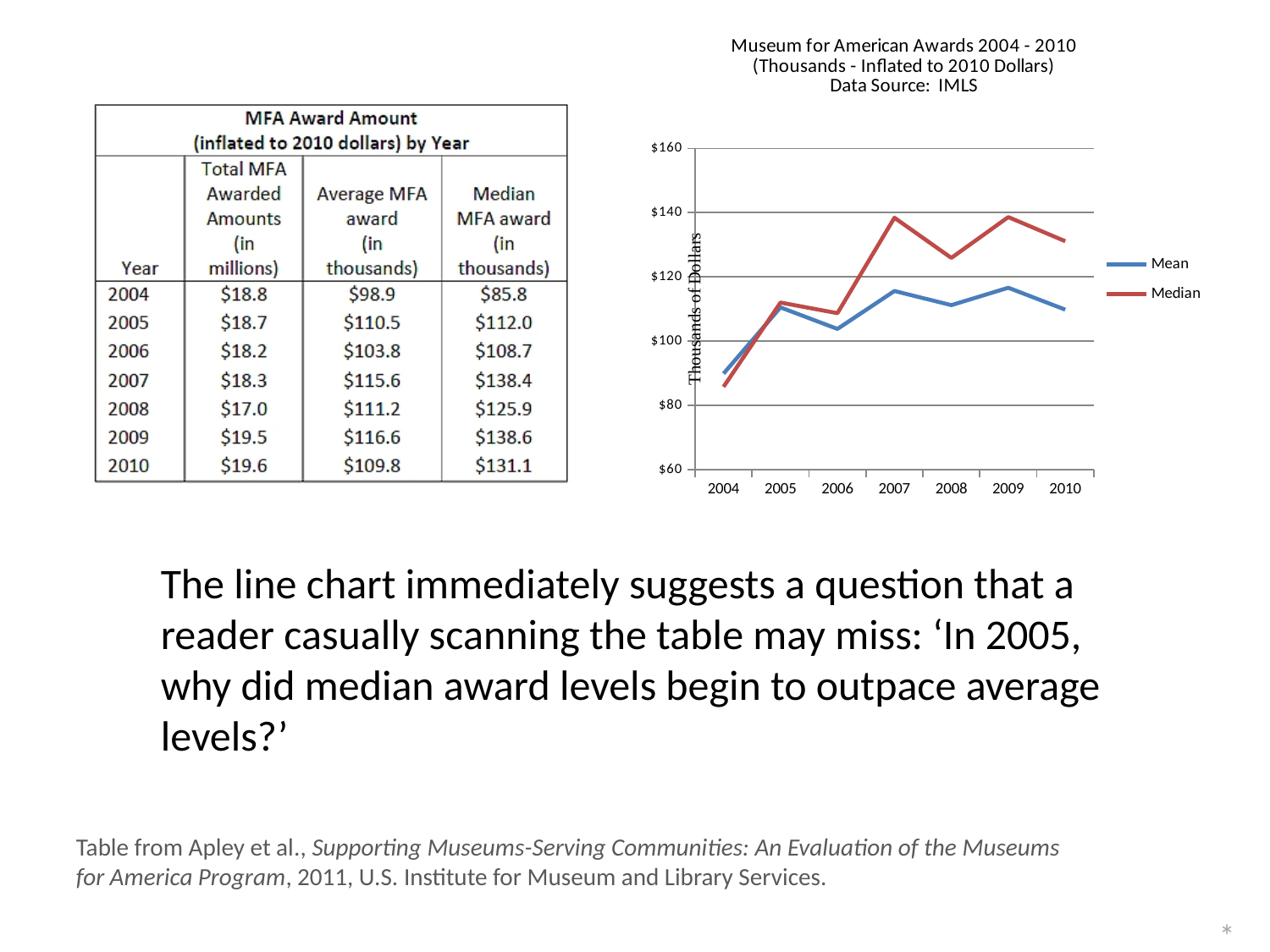
What is the y-axis label of the line chart? Thousands of Dollars In the line chart, is the Median value for 2004 greater or less than $100? less What kind of chart is shown on the right of the slide? line chart In the line chart, which series has the higher value in 2007, Mean or Median? Median In the line chart, which year has the lowest Median value? 2004 In the line chart, does the Median line rise or fall from 2009 to 2010? fall In the line chart, which year has the lowest Mean value? 2004 In the line chart, is the Mean value for 2010 greater or less than $100? greater In the line chart, is the Median value for 2007 greater or less than $120? greater How many years are plotted along the x axis of the line chart? 7 How many series does the legend of the line chart list? 2